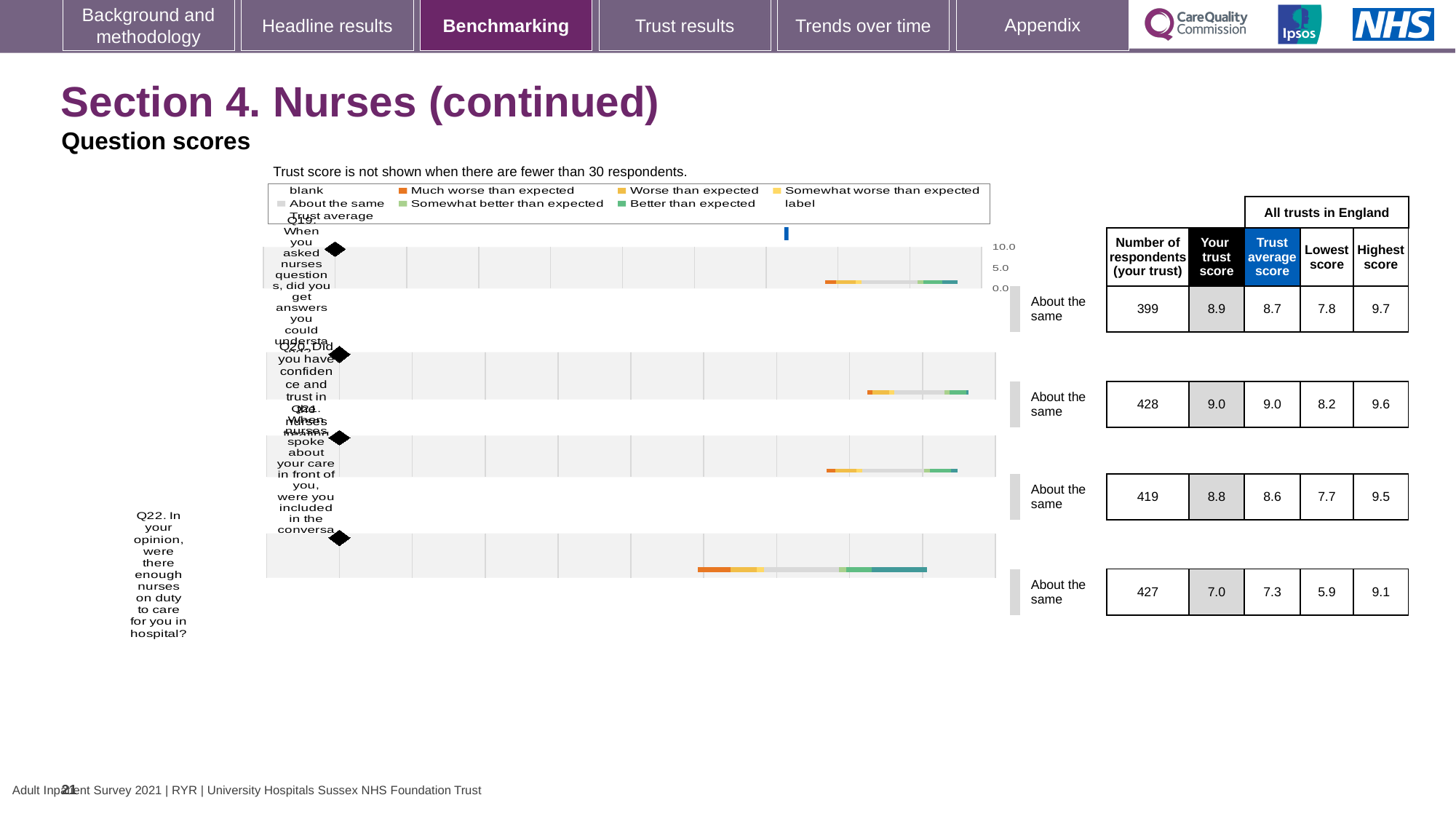
What is the highest score across all trusts in England for Q19? 9.7 Which question has the lowest trust score on this slide? Q22 What kind of chart is used to show the question scores? Bar chart Which question has the highest trust score on this slide? Q20 What is the lowest score across all trusts in England for Q22? 5.9 How many questions are plotted on the chart? 4 What is the trust score for Q22 (were there enough nurses on duty to care for you in hospital)? 7.0 For Q22, which is larger: the trust score or the trust average score? Trust average score What is the trust average score for Q21? 8.6 By how much does the trust score for Q19 exceed the trust average score for Q19? 0.2 How many respondents from the trust answered Q20 (did you have confidence and trust in the nurses)? 428 What benchmark category is shown for Q21 (were you included in the conversation)? About the same